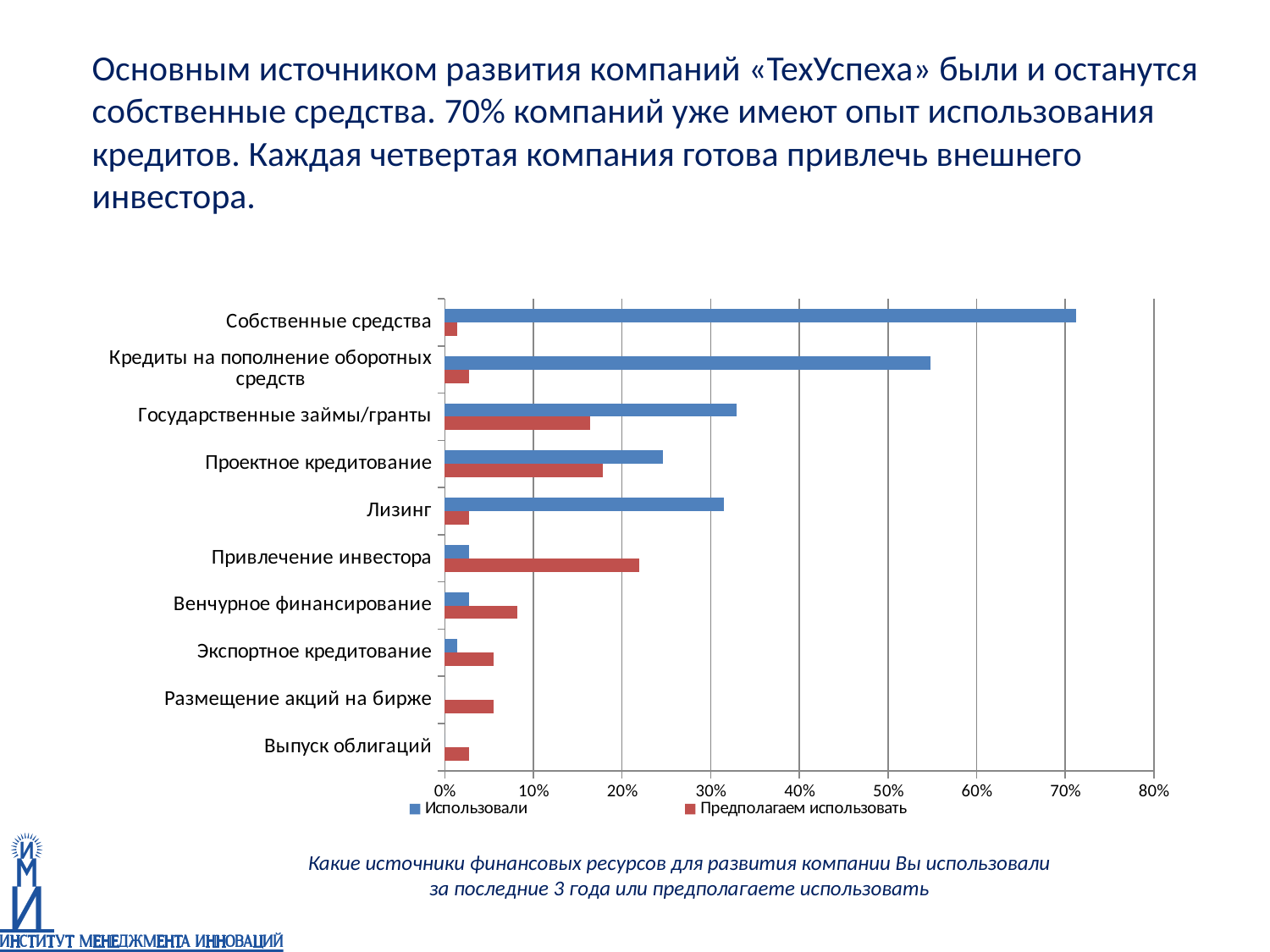
Is the value for "Кредиты на пополнение оборотных средств" in the series "Использовали" greater or less than 50%? greater Which category has the highest value for the series "Предполагаем использовать"? Привлечение инвестора Which category has the highest value for the series "Использовали"? Собственные средства For "Венчурное финансирование", which series has the larger value: "Использовали" or "Предполагаем использовать"? Предполагаем использовать Is the value for "Собственные средства" in the series "Использовали" greater or less than 70%? greater For "Государственные займы/гранты", which series has the larger value: "Использовали" or "Предполагаем использовать"? Использовали Is the value for "Привлечение инвестора" in the series "Предполагаем использовать" greater or less than 20%? greater Which colour represents the series "Предполагаем использовать" in the legend? red How many series does the legend list? 2 What kind of chart is shown on the slide? bar chart How many categories are shown on the chart? 10